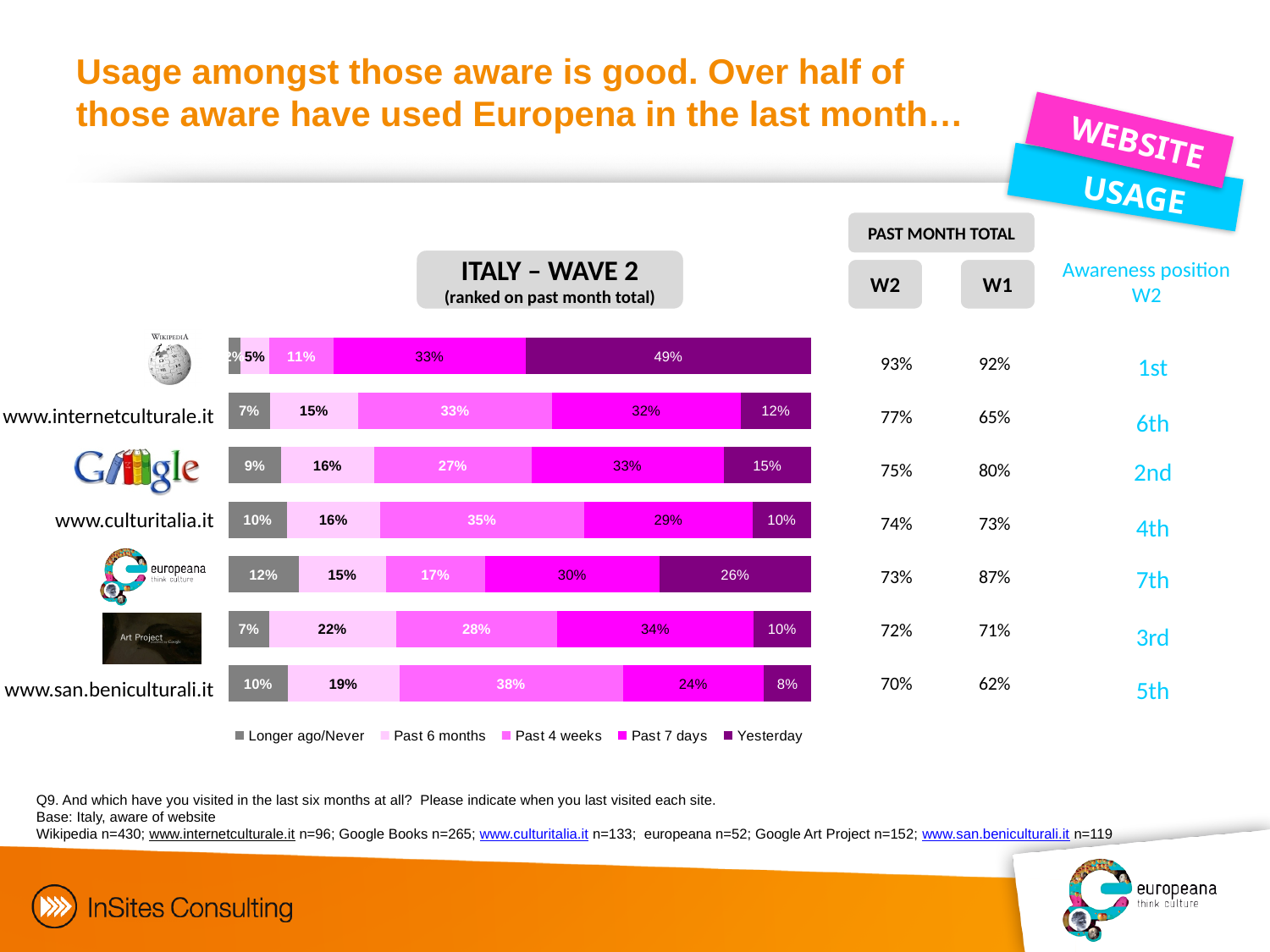
What is the title of the chart? ITALY – WAVE 2 (ranked on past month total) What is the 'Yesterday' value for Wikipedia? 49% What is the 'Past 4 weeks' value for www.san.beniculturali.it? 38% How many websites (categories) are plotted in the chart? 7 Which has a larger 'Past 4 weeks' value, www.culturitalia.it or europeana? www.culturitalia.it What kind of chart is shown on the slide? Stacked bar chart Which website has the lowest 'Yesterday' value? www.san.beniculturali.it What is the 'Past 6 months' value for Art Project? 22% What is the 'Longer ago/Never' value for europeana? 12% How many series does the chart legend list? 5 What is the difference between the 'Past 7 days' values for Art Project and www.san.beniculturali.it? 10% Which website has the highest 'Yesterday' value? Wikipedia